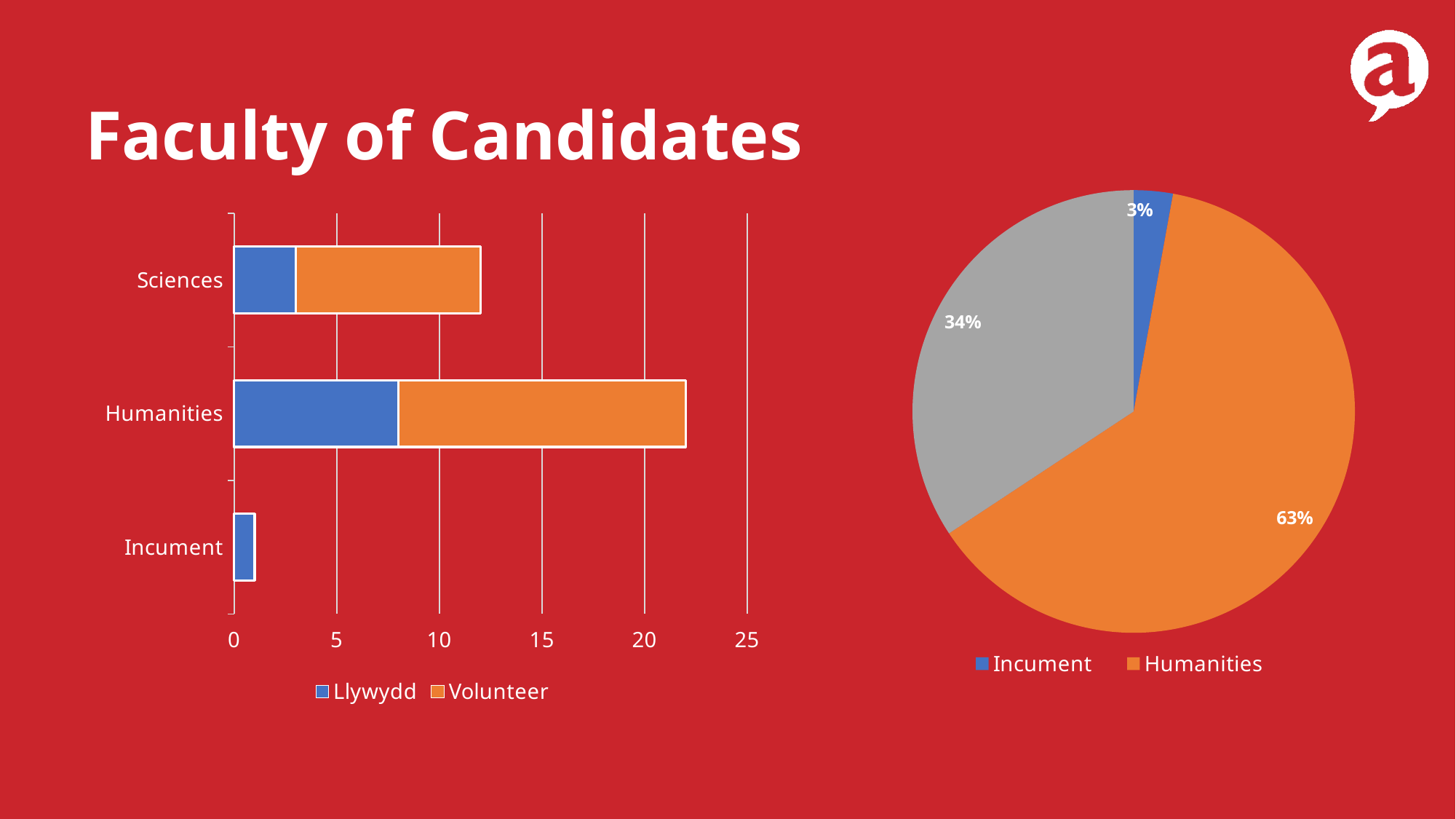
In the pie chart on the right, what share is labelled for Humanities? 63% In the bar chart on the left, which category has the longest total bar? Humanities In the bar chart on the left, which category has the shortest total bar? Incument In the bar chart on the left, is the Llywydd value for Humanities greater or less than 5? greater In the bar chart on the left, how many series does the legend list? 2 In the bar chart on the left, is the total bar for Sciences greater or less than 15? less In the bar chart on the left, how many categories are shown on the vertical axis? 3 In the bar chart on the left, is the total bar for Humanities greater or less than 20? greater What kind of chart is the chart on the left of the slide? bar chart In the pie chart on the right, what share is labelled for Incument? 3% What kind of chart is the chart on the right of the slide? pie chart In the pie chart on the right, which slice is the largest? Humanities